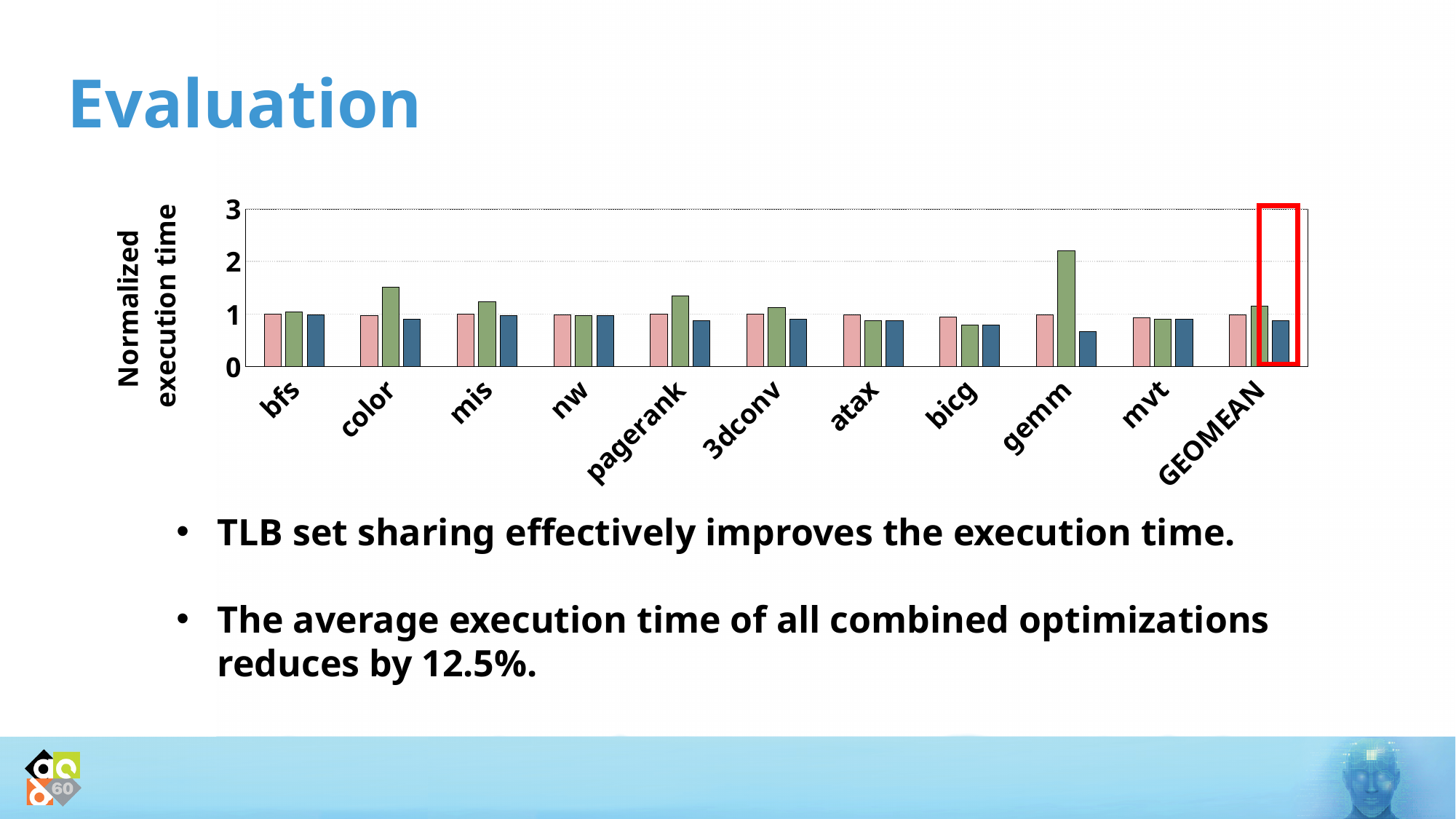
For the category gemm, which is larger: the pink bar or the green bar? green bar Which category has the tallest green bar in the chart? gemm Is the value of the green bar for gemm greater or less than 2? greater What is the label of the y axis of the chart? Normalized execution time What kind of chart is shown on the slide? bar chart Is the value of the green bar for bicg greater or less than 1? less Is the value of the green bar for color greater or less than 1? greater How many bars are plotted for each category in the chart? 3 For the category color, which is larger: the green bar or the blue bar? green bar Which category on the x axis is highlighted with a red box? GEOMEAN How many categories are shown along the x axis of the chart? 11